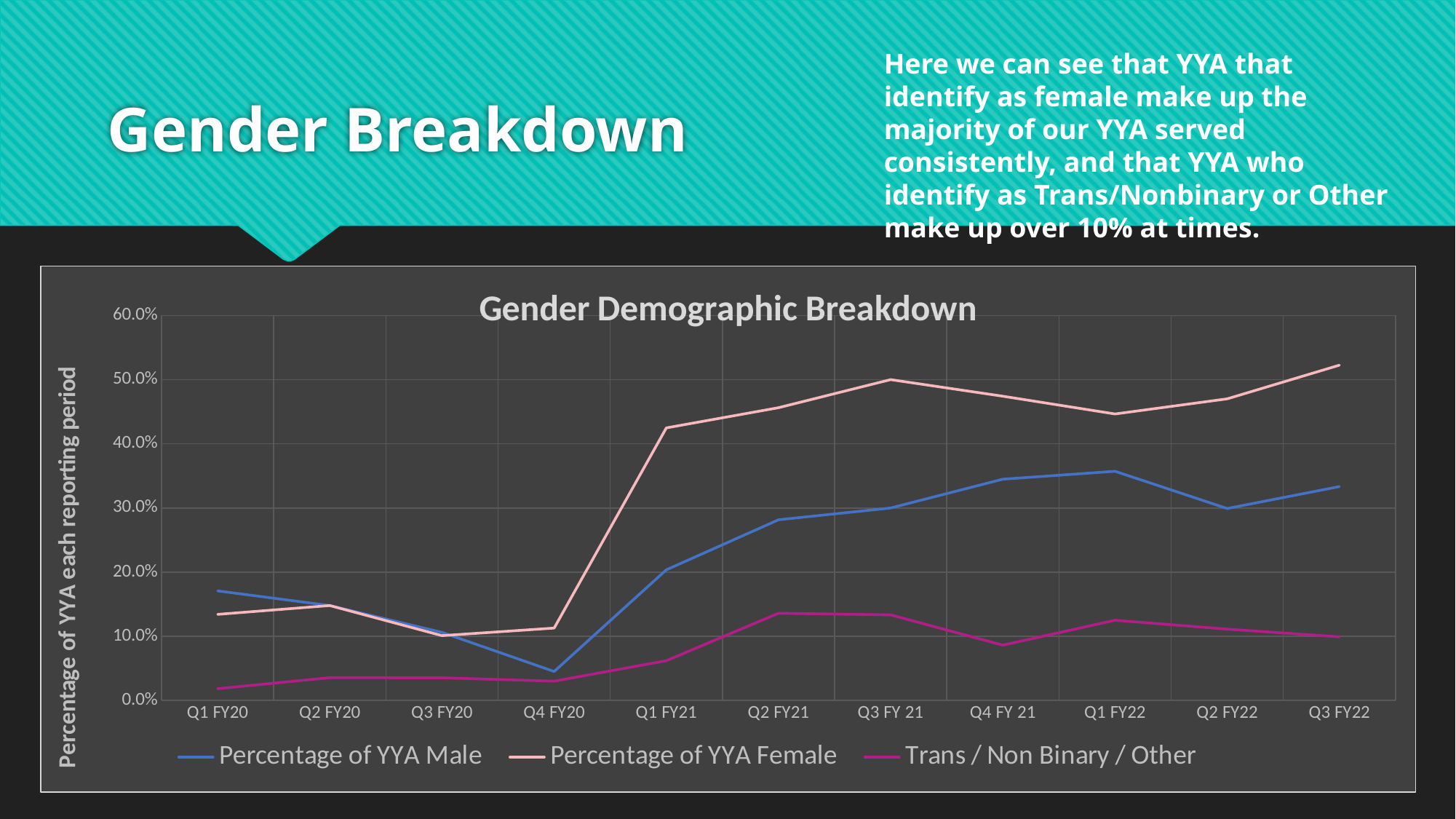
How many reporting periods are shown along the x axis of the chart? 11 Is the value for Percentage of YYA Male in Q4 FY20 greater or less than 10.0%? less Is the value for Trans / Non Binary / Other in Q2 FY21 greater or less than 10.0%? greater In Q3 FY22, which is larger: Percentage of YYA Female or Percentage of YYA Male? Percentage of YYA Female What is the title of the chart on the slide? Gender Demographic Breakdown In which reporting period is the Percentage of YYA Male at its lowest? Q4 FY20 How many series does the legend of the Gender Demographic Breakdown chart list? 3 Does the Percentage of YYA Female rise or fall between Q4 FY20 and Q1 FY21? Rise What kind of chart is shown on the slide? Line chart In Q1 FY20, which is larger: Percentage of YYA Male or Percentage of YYA Female? Percentage of YYA Male Is the value for Percentage of YYA Female in Q1 FY21 greater or less than 40.0%? greater